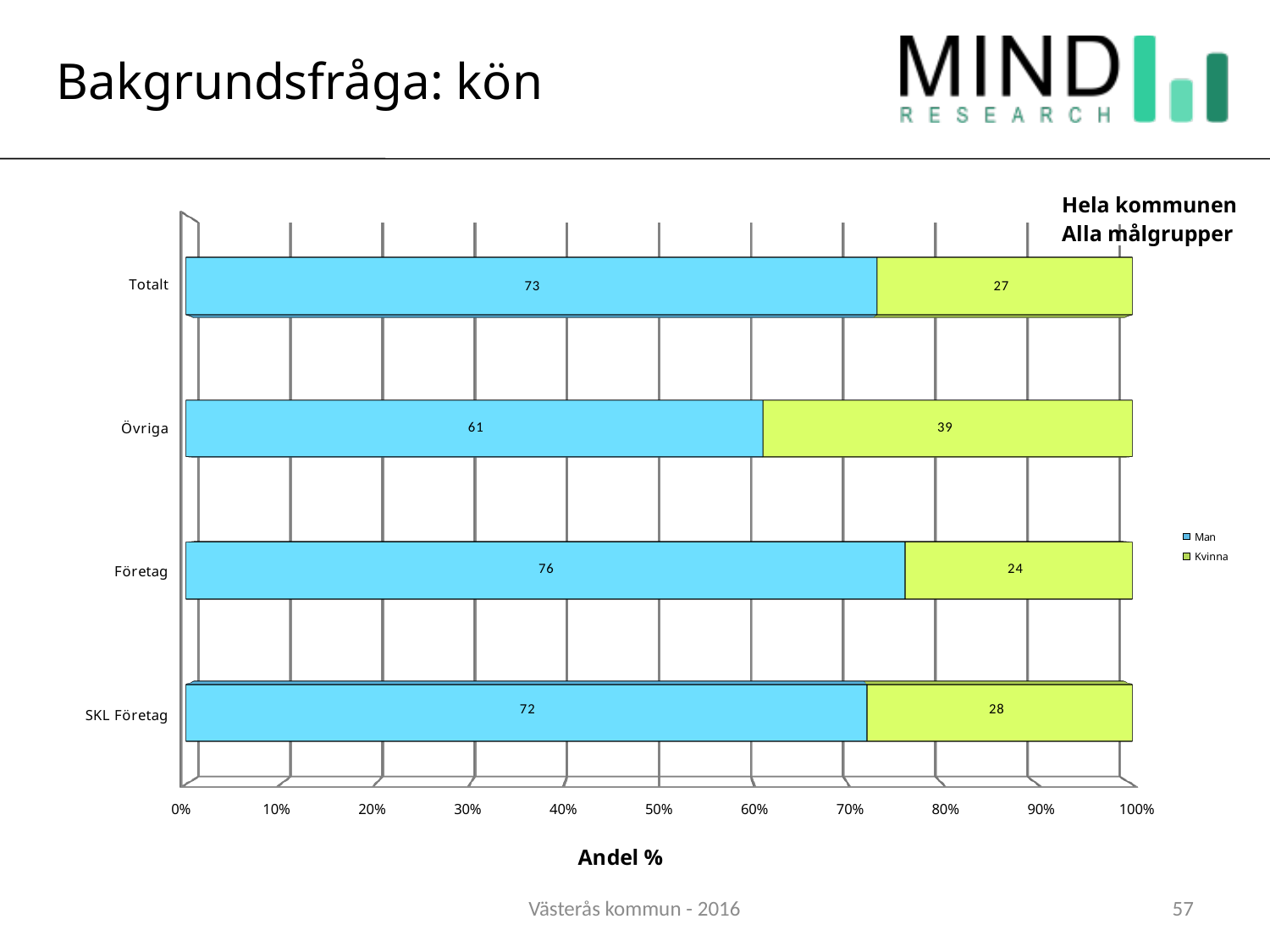
What is the label of the x axis? Andel % What is the difference between the Man value for Företag and the Man value for Övriga? 15 Which is larger: the Kvinna value for Totalt or the Kvinna value for SKL Företag? SKL Företag Which category has the highest value for Kvinna? Övriga What is the value for Man in the Övriga category? 61 What is the value for Kvinna in the Företag category? 24 What is the total of the stacked bar for Totalt? 100 How many series does the legend list? 2 What is the value for Man in the SKL Företag category? 72 How many categories are shown on the y axis? 4 What kind of chart is shown on the slide? Stacked bar chart Which category has the lowest value for Man? Övriga